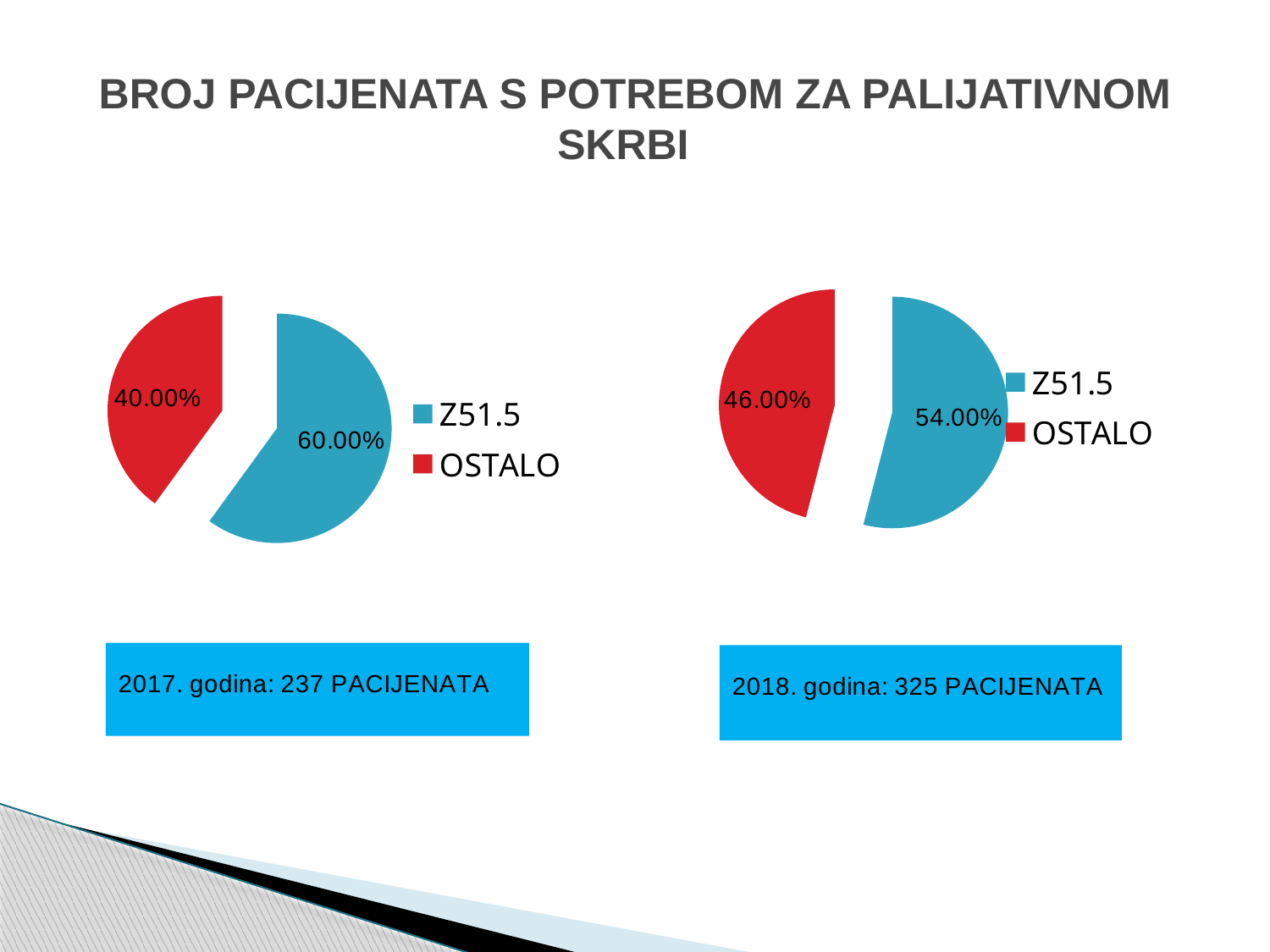
In the left pie chart (2017), what share does OSTALO have? 40.00% In the right pie chart (2018), what is the difference between the Z51.5 share and the OSTALO share? 8.00% In the left pie chart (2017), what share does Z51.5 have? 60.00% In the right pie chart (2018), what share does Z51.5 have? 54.00% In the left pie chart (2017), what is the difference between the Z51.5 share and the OSTALO share? 20.00% How many slices does the left pie chart (2017) have? 2 Is the Z51.5 share larger in the left pie chart (2017) or the right pie chart (2018)? Left (2017) In the right pie chart (2018), which slice is the smallest? OSTALO In the right pie chart (2018), what colour is the OSTALO slice? Red In the left pie chart (2017), which slice is the largest? Z51.5 In the right pie chart (2018), what share does OSTALO have? 46.00% What kind of chart is used on this slide? Pie chart